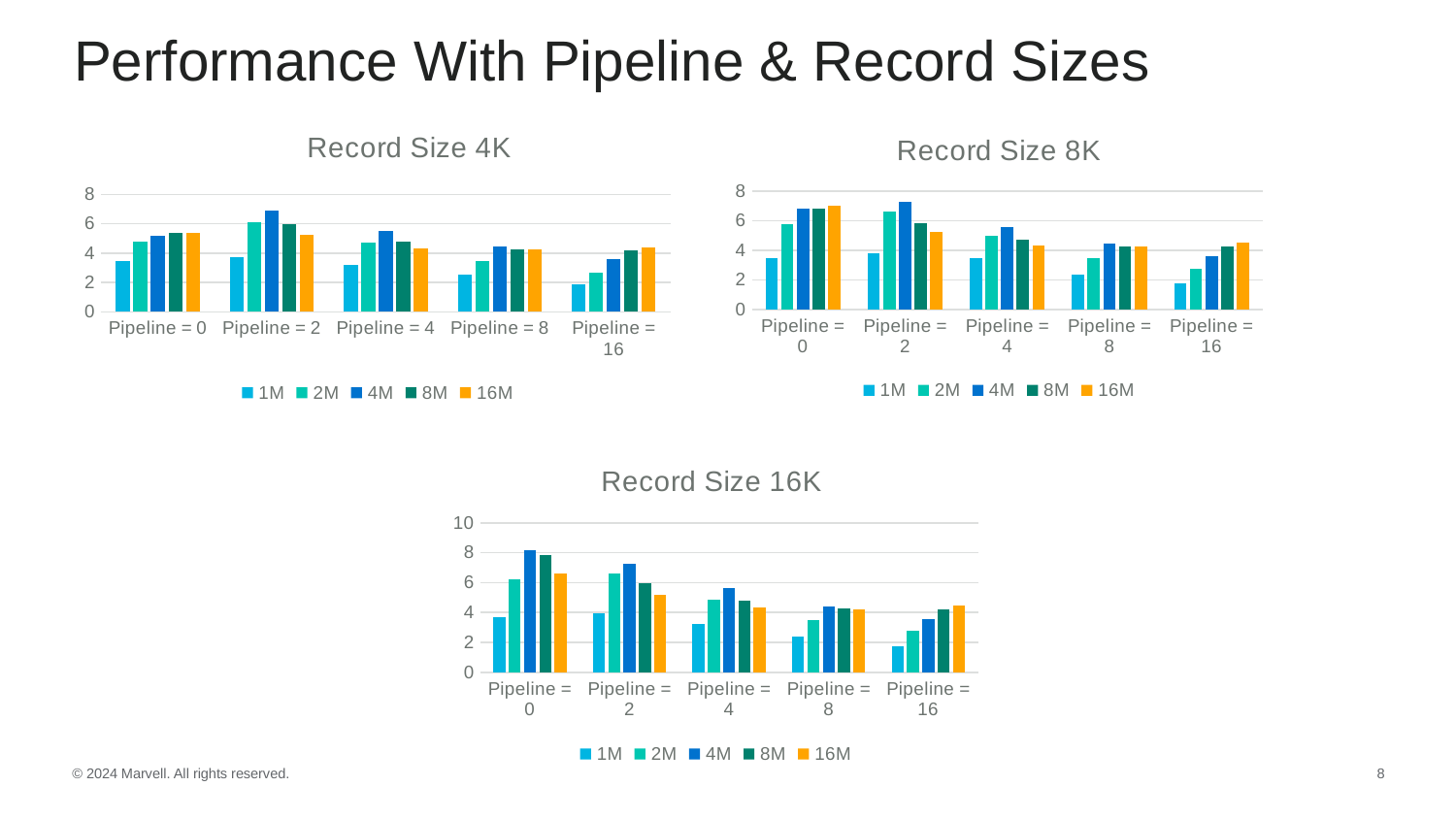
In the Record Size 16K chart, is the value for 8M at Pipeline = 0 greater or less than 6? greater In the Record Size 4K chart, is the value for 4M at Pipeline = 2 greater or less than 6? greater In the Record Size 16K chart, at which pipeline setting is the 4M bar highest? Pipeline = 0 How many series does the legend of the Record Size 8K chart list? 5 What is the highest value shown on the vertical axis of the Record Size 16K chart? 10 How many pipeline categories are shown on the x axis of the Record Size 16K chart? 5 In the Record Size 16K chart, at Pipeline = 0, which is larger: 4M or 2M? 4M In the Record Size 8K chart, which series has the highest bar at Pipeline = 2? 4M In the Record Size 4K chart, is the value for 1M at Pipeline = 8 greater or less than 4? less In the Record Size 4K chart, from Pipeline = 2 to Pipeline = 16, does the 4M series rise or fall? fall What kind of chart is the Record Size 4K chart? bar chart In the Record Size 8K chart, which series has the lowest bar at Pipeline = 16? 1M